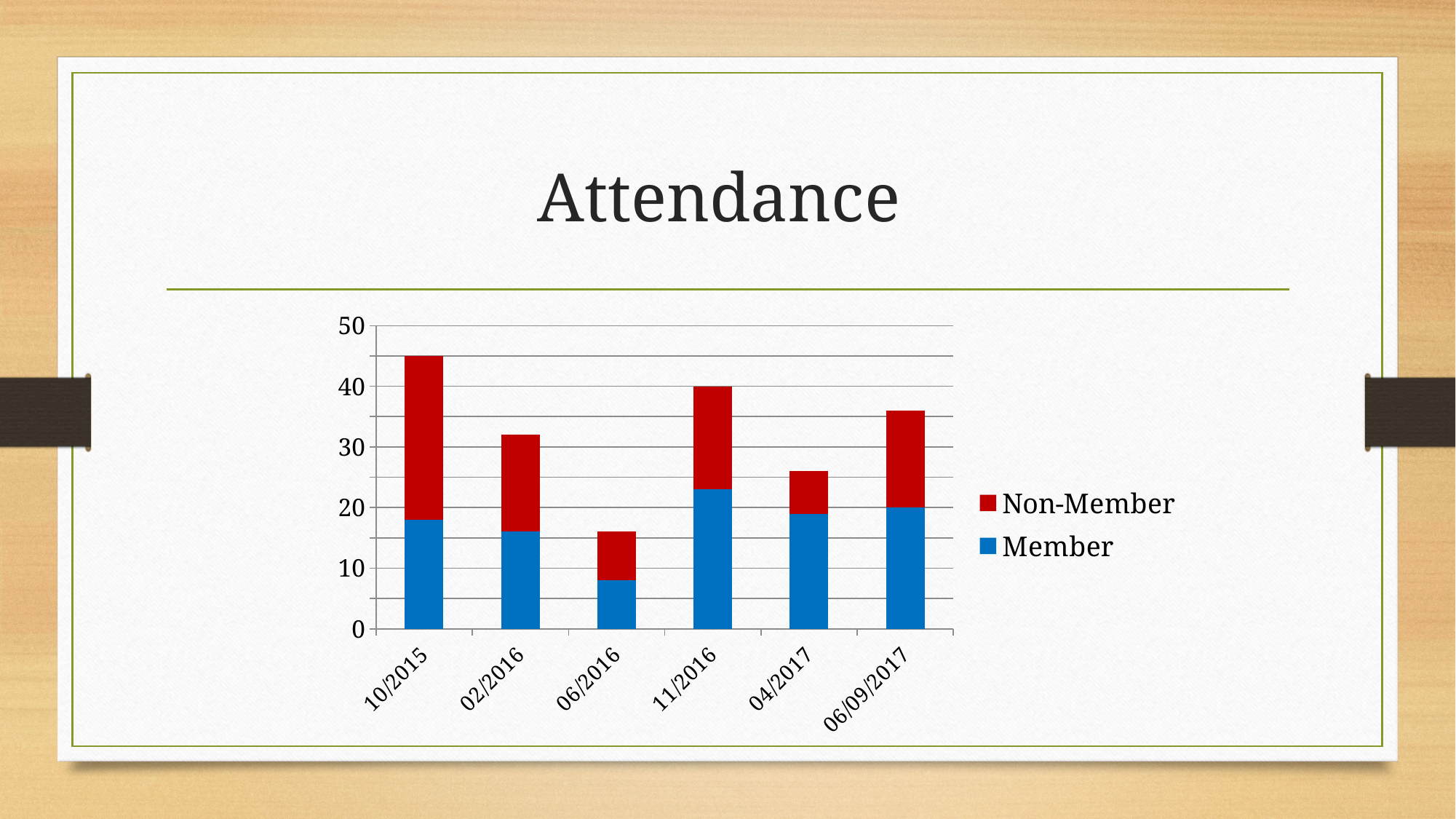
Which has the larger total attendance, 02/2016 or 06/09/2017? 06/09/2017 Which has the larger Member value, 11/2016 or 04/2017? 11/2016 Is the Member value for 06/2016 greater or less than 10? less Which date has the lowest total attendance? 06/2016 How many series does the legend list? 2 Is the total attendance for 06/2016 greater or less than 20? less Which date has the highest total attendance? 10/2015 What kind of chart is shown on the slide? Stacked bar chart How many dates are shown along the x axis of the chart? 6 Which date has the lowest Member value? 06/2016 Is the total attendance for 10/2015 greater or less than 40? greater What are the two entries in the chart's legend? Non-Member and Member